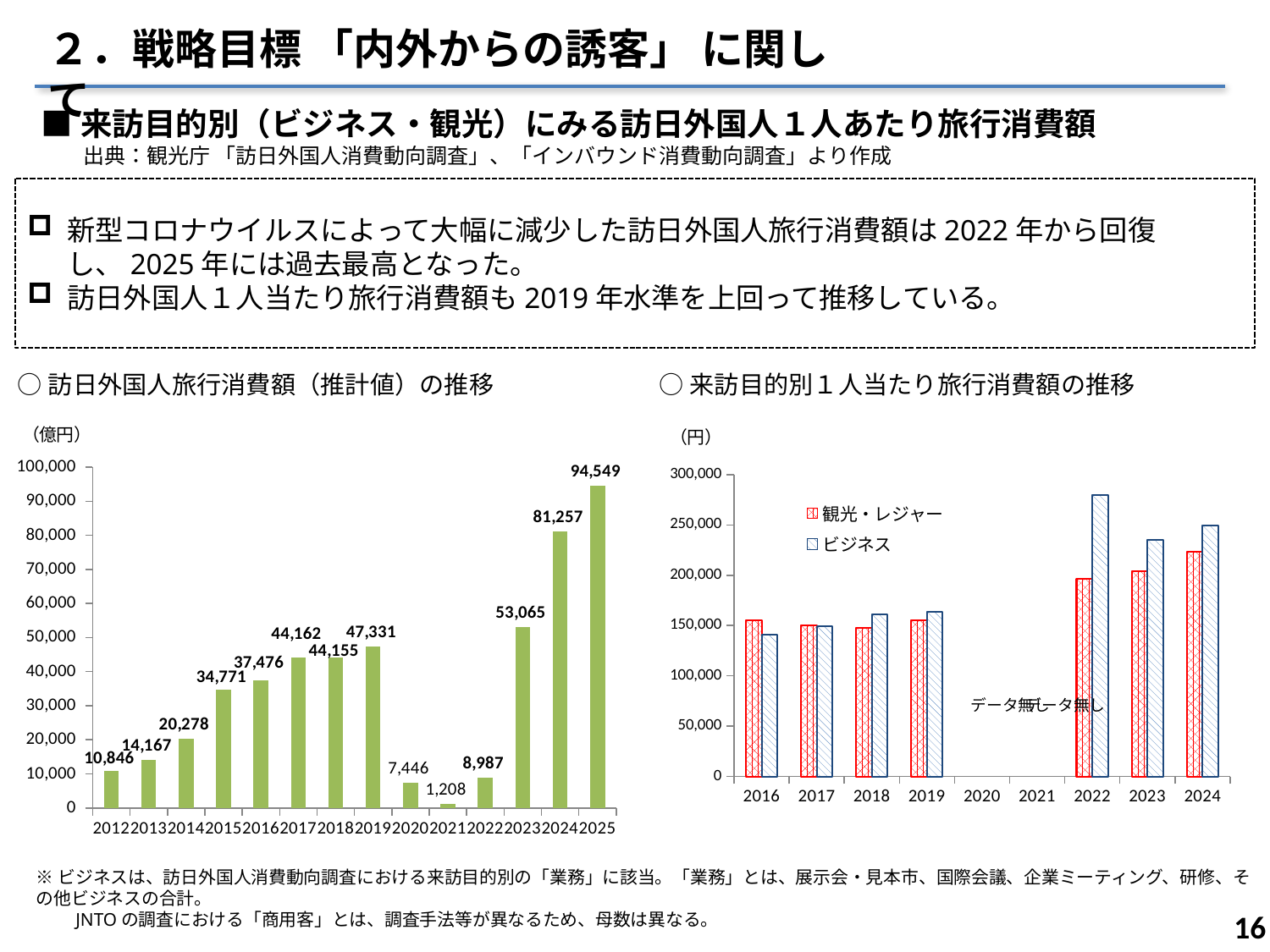
In the left chart (訪日外国人旅行消費額（推計値）の推移), how many years are shown on the x axis? 14 In the left chart (訪日外国人旅行消費額（推計値）の推移), which year has the lowest value? 2021 In the left chart (訪日外国人旅行消費額（推計値）の推移), which year has the larger value, 2015 or 2016? 2016 In the right chart (来訪目的別１人当たり旅行消費額の推移), how many series does the legend list? 2 In the right chart (来訪目的別１人当たり旅行消費額の推移), which series has the larger value in 2022, 観光・レジャー or ビジネス? ビジネス In the left chart (訪日外国人旅行消費額（推計値）の推移), what is the difference between the 2025 and 2024 values? 13,292 In the left chart (訪日外国人旅行消費額（推計値）の推移), do the values rise or fall from 2022 to 2025? rise What kind of chart is the left chart (訪日外国人旅行消費額（推計値）の推移)? bar chart In the left chart (訪日外国人旅行消費額（推計値）の推移), what is the value for 2020? 7,446 In the right chart (来訪目的別１人当たり旅行消費額の推移), is the value for ビジネス in 2022 greater or less than 250,000? greater In the left chart (訪日外国人旅行消費額（推計値）の推移), which year has the highest value? 2025 In the left chart (訪日外国人旅行消費額（推計値）の推移), what is the value for 2025? 94,549